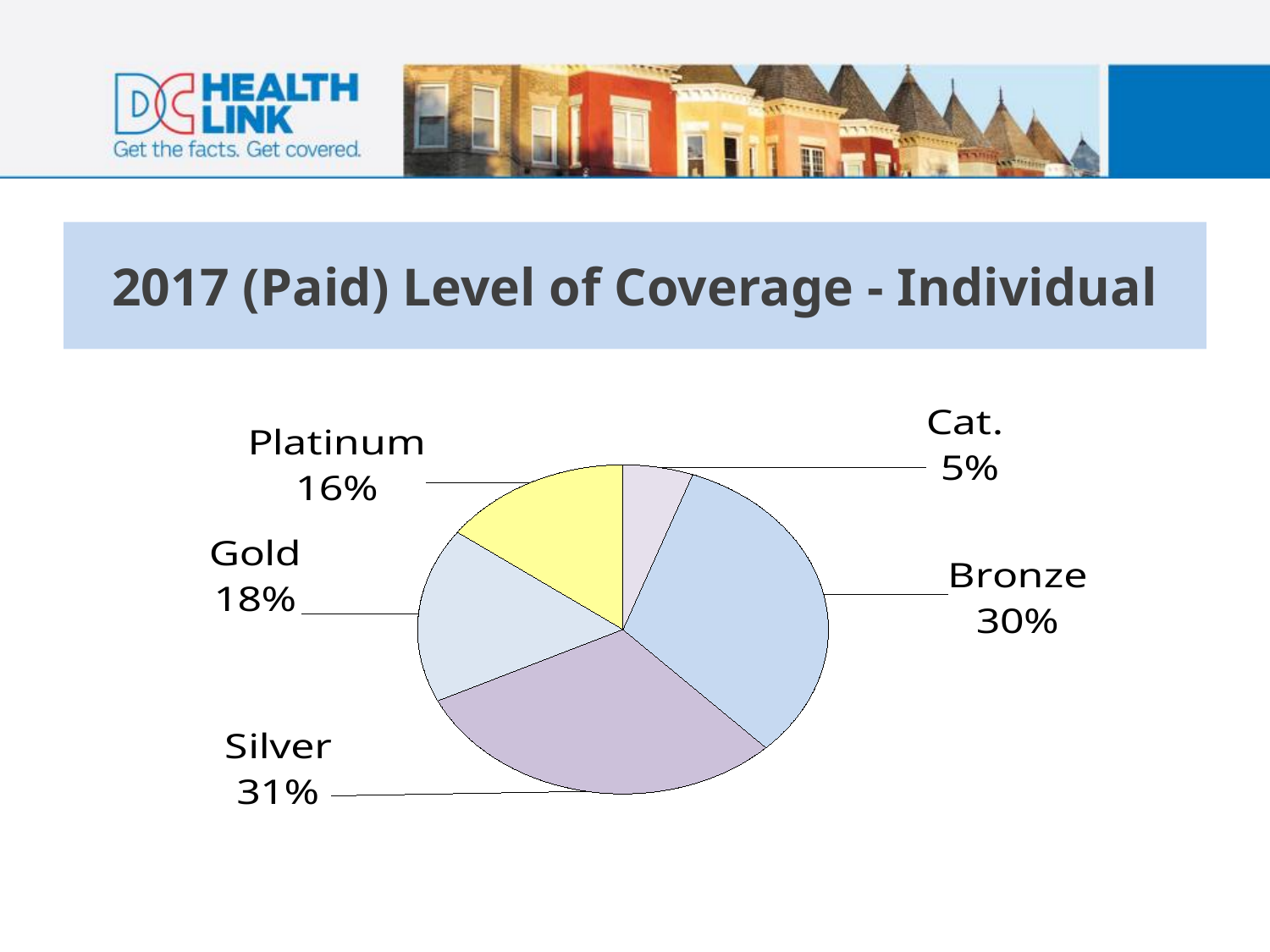
Which level of coverage has the smallest share? Cat. What is the value for Gold? 18% Which is larger, Gold or Platinum? Gold What is the value for Cat.? 5% Which level of coverage has the largest share? Silver What is the difference between the Gold and Platinum shares? 2% What is the value for Platinum? 16% What kind of chart is shown on the slide? Pie chart What is the difference between the Bronze and Cat. shares? 25% What share of the pie does Silver have? 31% How many slices does the pie chart have? 5 What is the value for Bronze? 30%